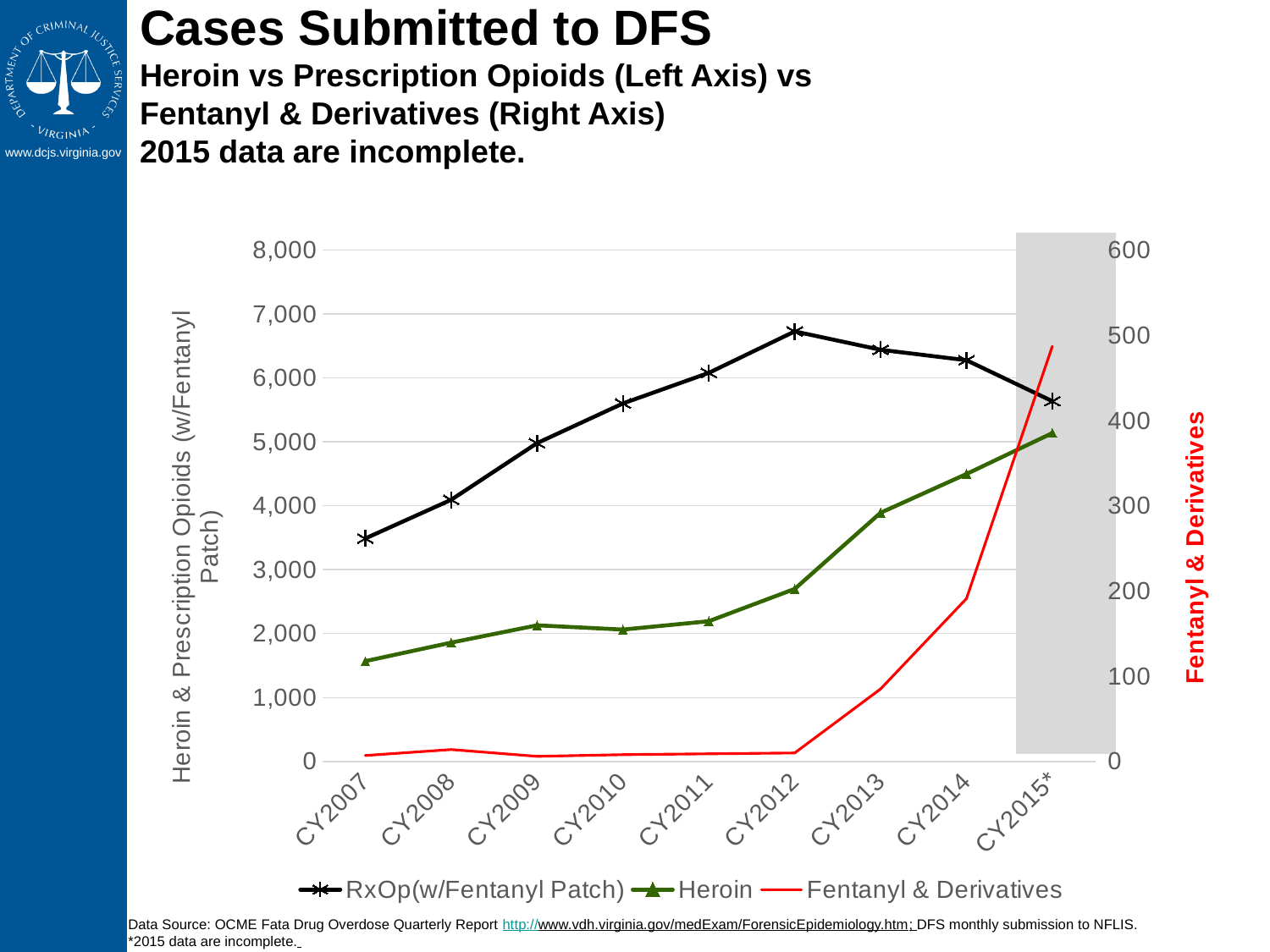
Is the Fentanyl & Derivatives value for CY2015* greater or less than 400 on the right axis? greater In which year does the Heroin series reach its highest value? CY2015* Does the Heroin series generally rise or fall from CY2007 to CY2015*? rise How many calendar years are plotted along the x axis? 9 What type of chart is shown on the slide? line chart How many series does the legend list? 3 Is the RxOp(w/Fentanyl Patch) value for CY2012 greater or less than 6,000? greater Is the Heroin value for CY2007 greater or less than 2,000? less Which series is plotted against the right axis? Fentanyl & Derivatives In which year does the RxOp(w/Fentanyl Patch) series reach its highest value? CY2012 In CY2012, which series has the larger value: RxOp(w/Fentanyl Patch) or Heroin? RxOp(w/Fentanyl Patch) In which year is the RxOp(w/Fentanyl Patch) series at its lowest value? CY2007